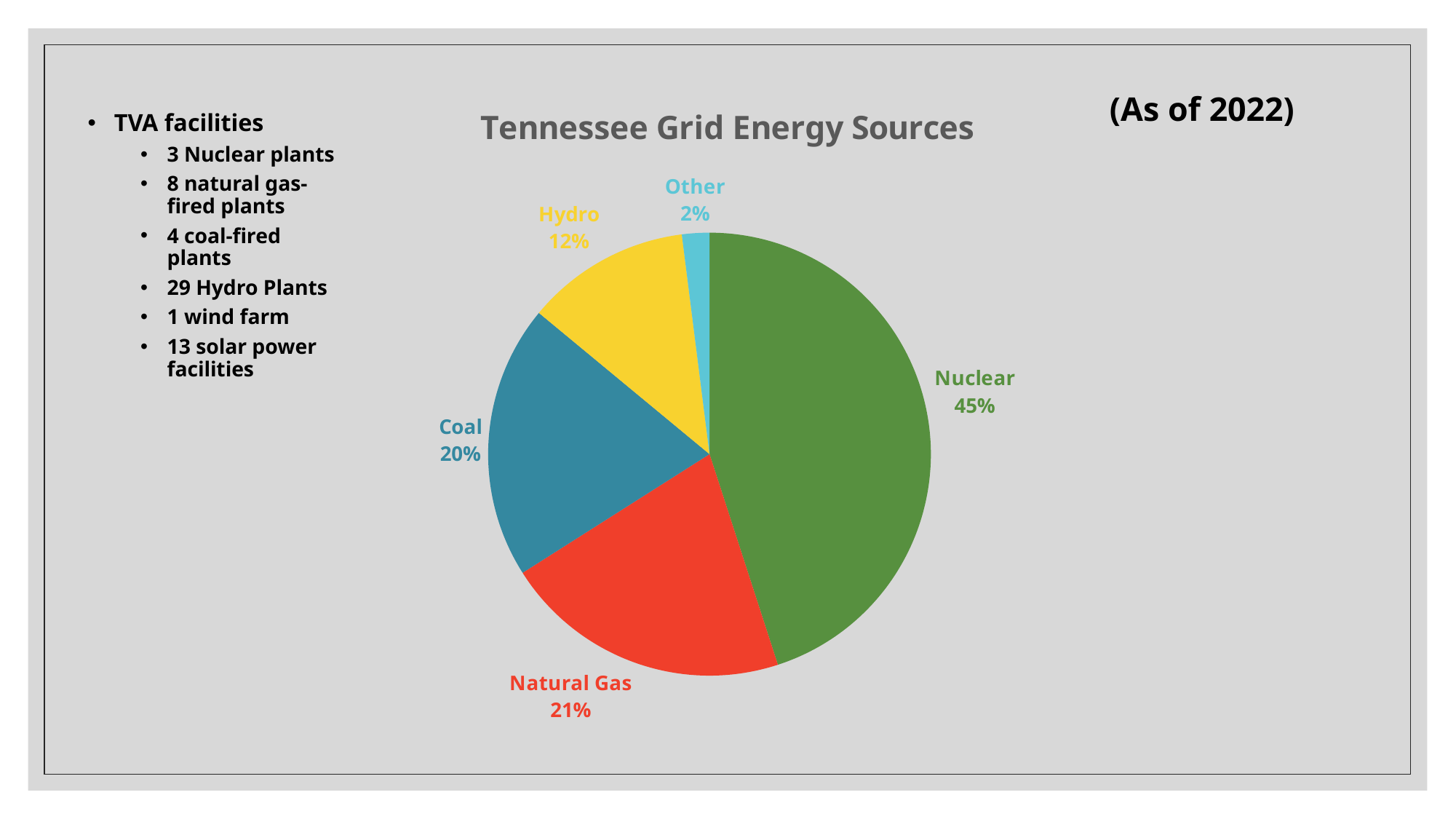
What is the value shown for Coal? 20% Which is larger, the share for Hydro or the share for Coal? Coal What is the value shown for Other? 2% What is the difference in percentage points between Nuclear and Natural Gas? 24 What type of chart is shown on the slide? pie chart How many slices does the pie chart have? 5 What share of the pie does Nuclear represent? 45% What is the title of the chart? Tennessee Grid Energy Sources What is the value shown for Hydro? 12% What is the value shown for Natural Gas? 21% Which energy source has the largest share of the pie? Nuclear Which energy source has the smallest share of the pie? Other